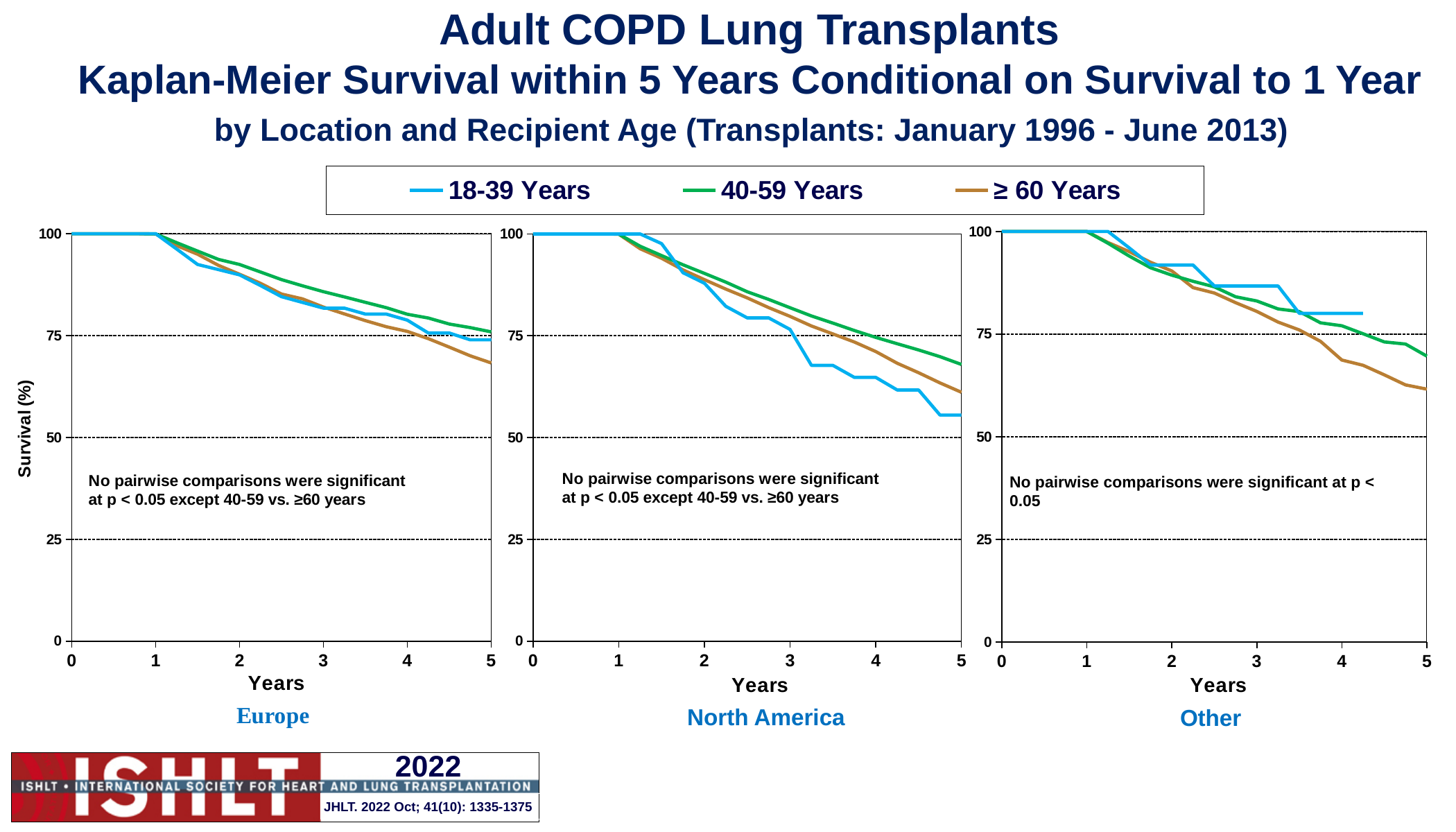
What kind of chart is used for the Europe panel? line chart In the North America chart, is the survival for 18-39 Years at year 5 greater or less than 50? greater What is the label on the y-axis of the Europe chart? Survival (%) In the North America chart, which age group has the lowest survival at year 5? 18-39 Years In the Other chart, do the survival curves rise or fall as years increase? fall In the Other chart, is the survival for ≥ 60 Years at year 5 greater or less than 75? less In the North America chart, which age group has the highest survival at year 5? 40-59 Years In the North America chart, is the survival for 18-39 Years at year 5 greater or less than 75? less How many charts (panels) are shown on the slide? 3 In the Europe chart, which is larger at year 5: survival for 40-59 Years or for ≥ 60 Years? 40-59 Years How many series does the legend list? 3